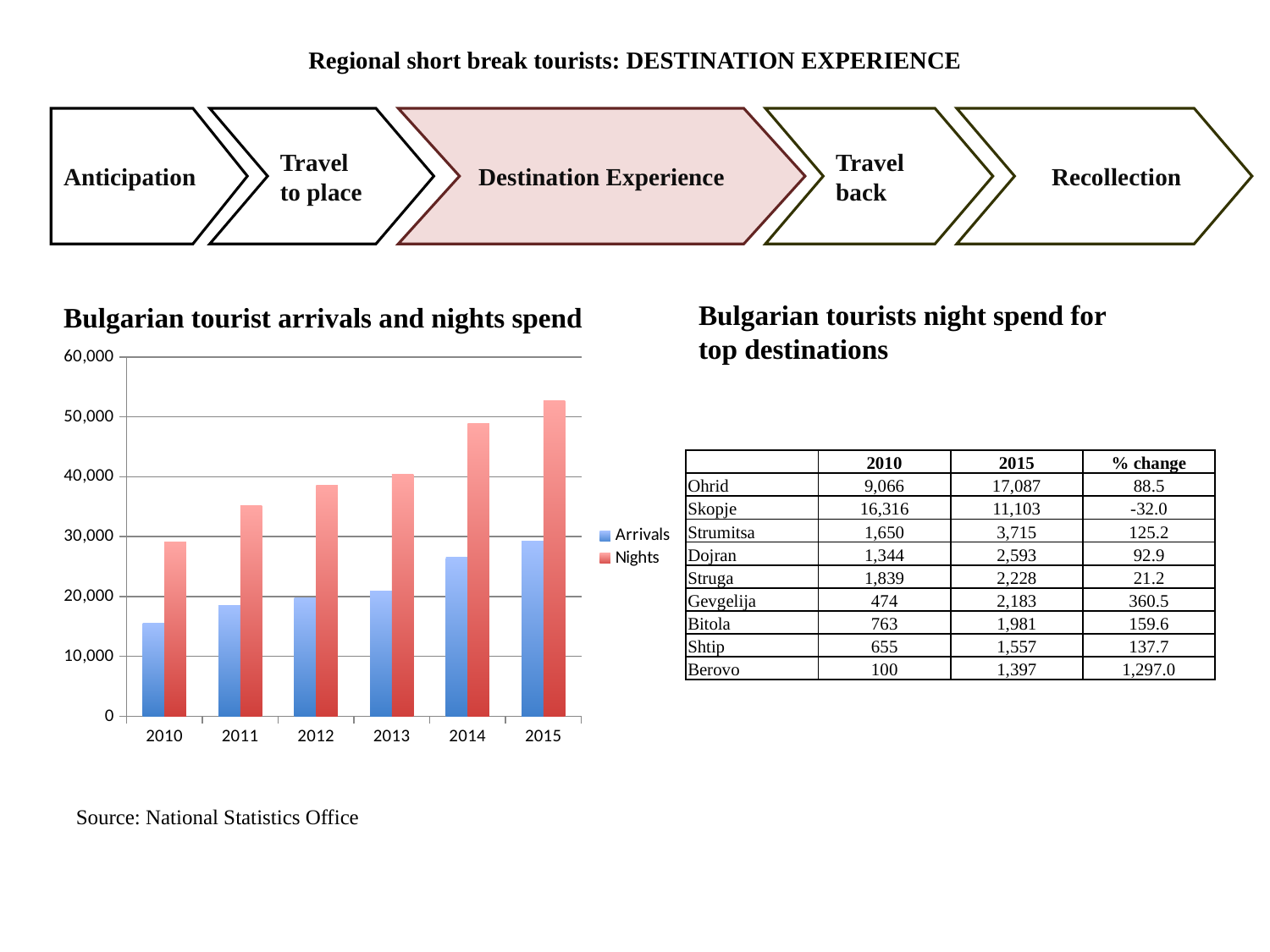
What are the two series shown in the "Bulgarian tourist arrivals and nights spend" chart? Arrivals and Nights Is the Arrivals value for 2014 greater or less than 20,000 in the "Bulgarian tourist arrivals and nights spend" chart? greater In which year is the Nights value highest in the "Bulgarian tourist arrivals and nights spend" chart? 2015 In which year is the Arrivals value lowest in the "Bulgarian tourist arrivals and nights spend" chart? 2010 In the "Bulgarian tourist arrivals and nights spend" chart, which is larger in 2014, Arrivals or Nights? Nights How many series does the legend of the "Bulgarian tourist arrivals and nights spend" chart list? 2 How many years are shown on the x axis of the "Bulgarian tourist arrivals and nights spend" chart? 6 Do the Nights values rise or fall from 2010 to 2015 in the "Bulgarian tourist arrivals and nights spend" chart? Rise What kind of chart is "Bulgarian tourist arrivals and nights spend"? Bar chart Which colour represents the Nights series in the "Bulgarian tourist arrivals and nights spend" chart? Red Is the Nights value for 2012 greater or less than 40,000 in the "Bulgarian tourist arrivals and nights spend" chart? less Is the Nights value for 2015 greater or less than 50,000 in the "Bulgarian tourist arrivals and nights spend" chart? greater